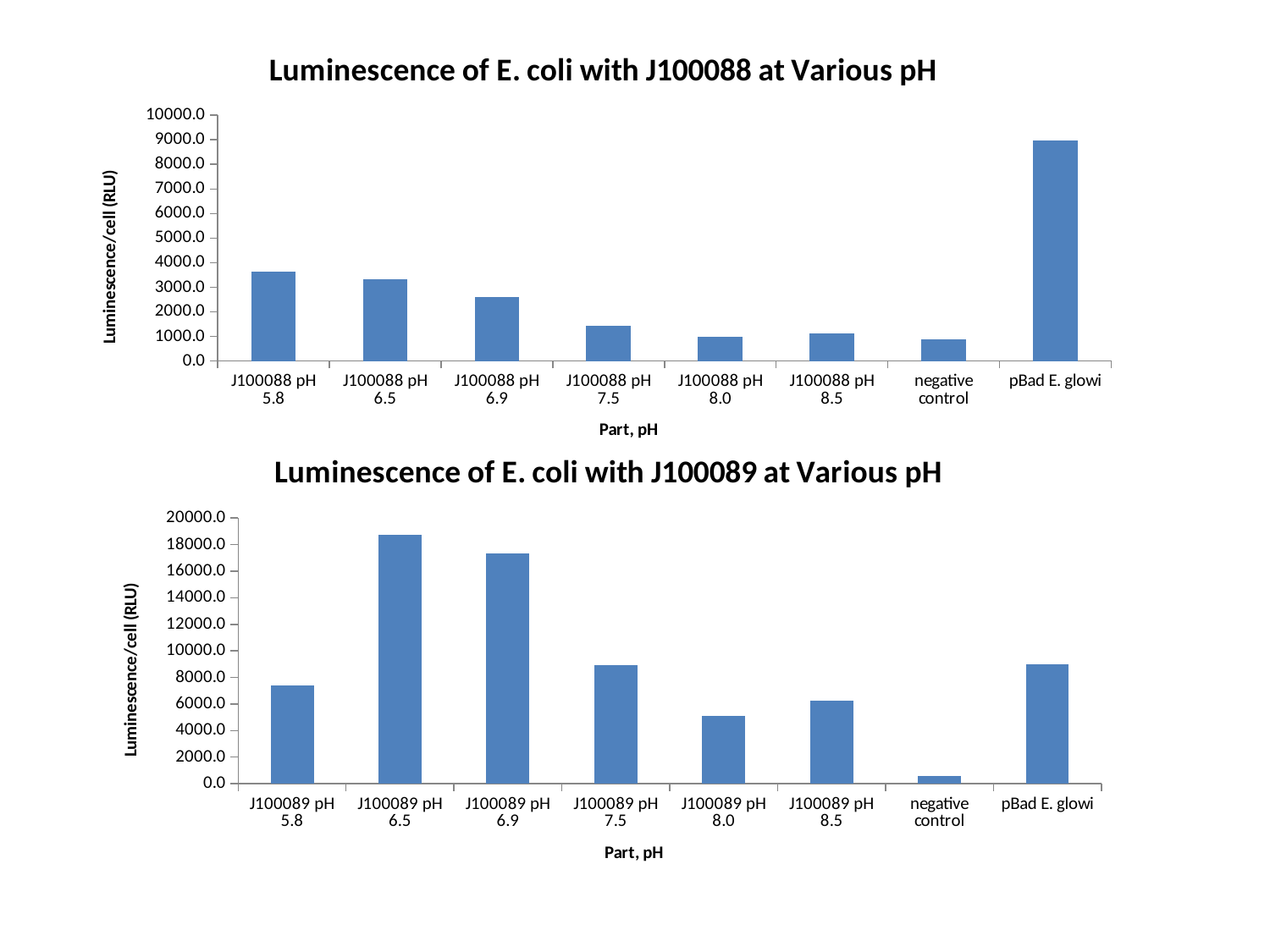
What kind of chart is the bottom chart (Luminescence of E. coli with J100089 at Various pH)? bar chart In the bottom chart (J100089), which is larger: the value for J100089 pH 7.5 or J100089 pH 8.5? J100089 pH 7.5 In the top chart (J100088), is the value for pBad E. glowi greater or less than 8000.0? greater In the bottom chart (Luminescence of E. coli with J100089 at Various pH), which category has the highest luminescence? J100089 pH 6.5 In the top chart (J100088), is the value for J100088 pH 5.8 greater or less than 3000.0? greater In the top chart (J100088), do the values rise or fall from J100088 pH 5.8 to J100088 pH 8.0? fall In the bottom chart (J100089), is the value for J100089 pH 6.5 greater or less than 18000.0? greater How many categories are shown on the x axis of the top chart (J100088)? 8 In the bottom chart (Luminescence of E. coli with J100089 at Various pH), which category has the lowest luminescence? negative control In the top chart (J100088), which is larger: the value for J100088 pH 6.9 or J100088 pH 7.5? J100088 pH 6.9 In the top chart (Luminescence of E. coli with J100088 at Various pH), which category has the highest luminescence? pBad E. glowi